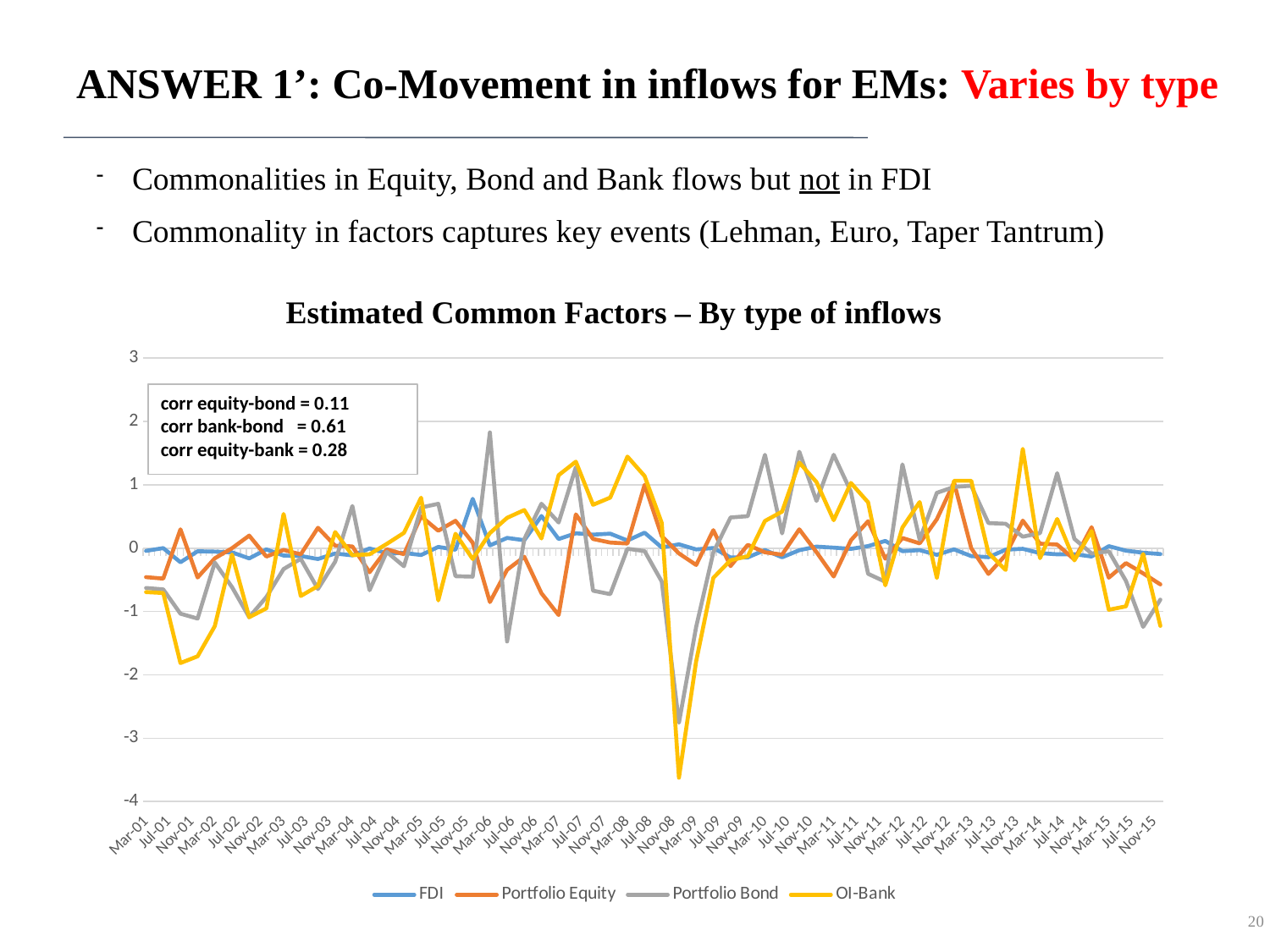
Is the lowest value of the OI-Bank series greater or less than -3? less Which series is shown in yellow in the chart legend? OI-Bank What is the lowest value shown on the vertical axis of the chart? -4 What is the title of the chart? Estimated Common Factors – By type of inflows Which series reaches the lowest value on the chart? OI-Bank Is the peak value of the Portfolio Bond series around Mar-06 greater or less than 1? greater What is the correlation between equity and bond factors printed on the chart? 0.11 Is the lowest value of the Portfolio Bond series greater or less than -2? less What is the correlation between equity and bank factors printed on the chart? 0.28 What kind of chart is shown on the slide? line chart What is the correlation between bank and bond factors printed on the chart? 0.61 How many series does the chart legend list? 4